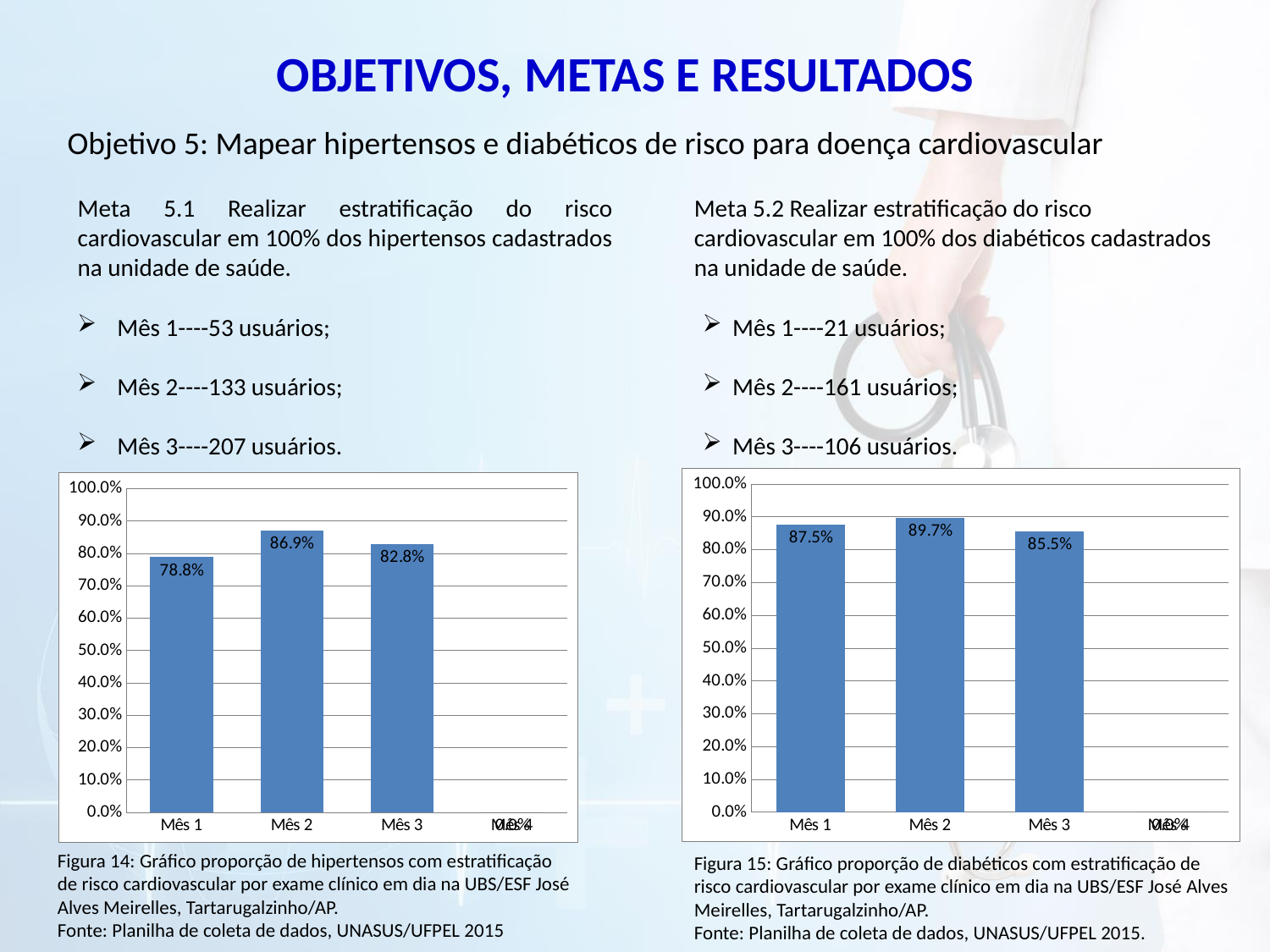
In the right chart (Figura 15, diabéticos), what is the value for Mês 2? 89.7% In the right chart (Figura 15, diabéticos), what is the difference between the values for Mês 2 and Mês 3? 4.2 percentage points In the right chart (Figura 15, diabéticos), what is the value for Mês 3? 85.5% In the left chart (Figura 14, hipertensos), what is the value for Mês 1? 78.8% In the right chart (Figura 15, diabéticos), which month has the highest value? Mês 2 What type of chart is used in Figura 14 on the left? Bar chart In the left chart (Figura 14, hipertensos), what is the difference between the values for Mês 2 and Mês 1? 8.1 percentage points In the right chart (Figura 15, diabéticos), what is the value for Mês 1? 87.5% In the right chart (Figura 15, diabéticos), is the value for Mês 1 greater or less than 80.0%? greater In the left chart (Figura 14, hipertensos), which month has the highest value? Mês 2 In the left chart (Figura 14, hipertensos), what is the value for Mês 3? 82.8% In the left chart (Figura 14, hipertensos), what is the value for Mês 2? 86.9%